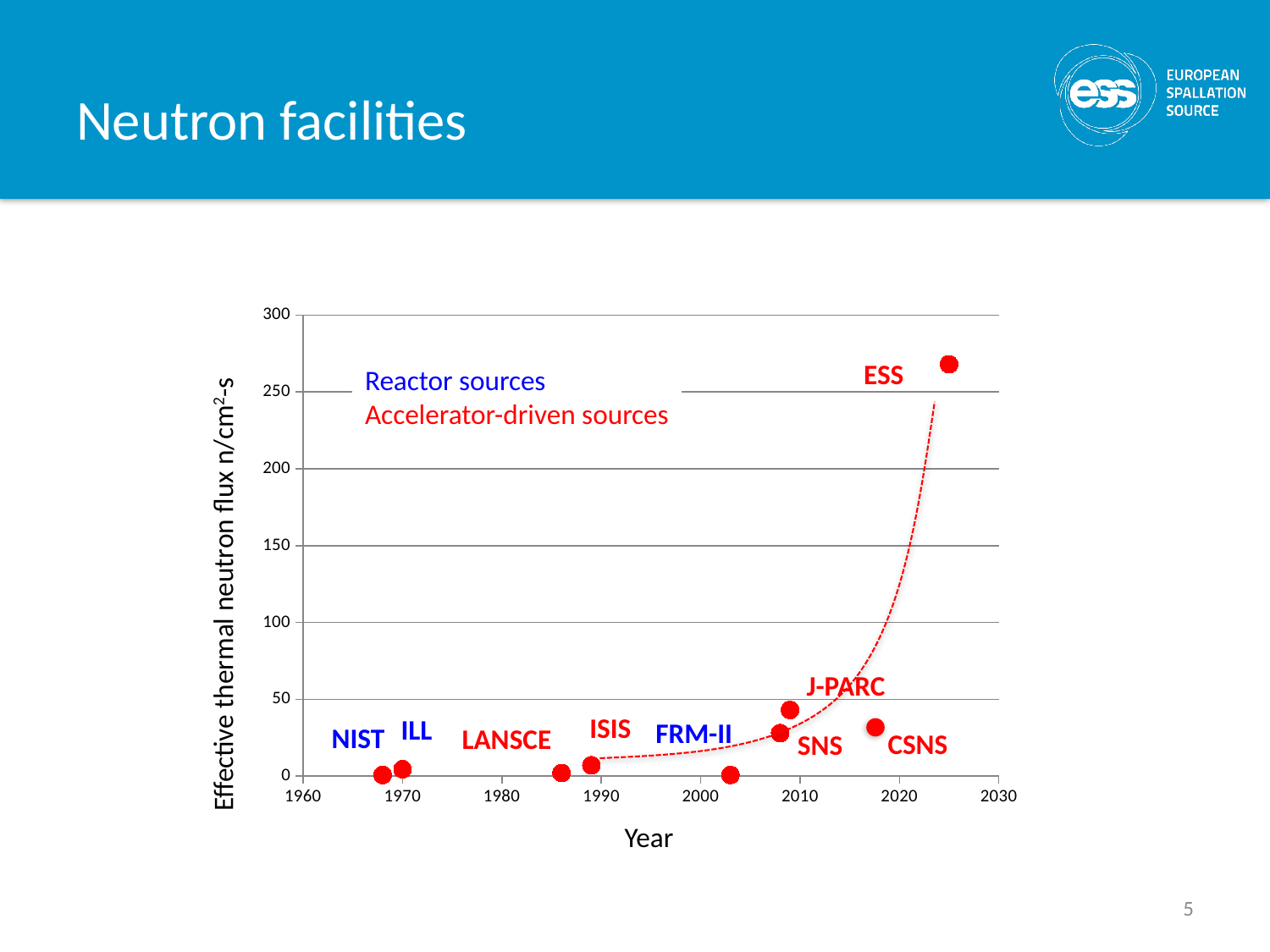
What kind of chart is shown on the slide? scatter chart Is the value for SNS greater or less than 50? less Which has a higher effective thermal neutron flux, J-PARC or SNS? J-PARC Is the value for ESS greater or less than 200? greater What colour is used for the labels of reactor sources in the chart? blue What is the label of the y axis? Effective thermal neutron flux n/cm²-s Is the value for J-PARC greater or less than 50? less How many facilities are plotted on the chart? 9 Do the plotted values generally rise or fall as the year increases? rise Which facility has the highest effective thermal neutron flux on the chart? ESS Which has a higher effective thermal neutron flux, ESS or CSNS? ESS